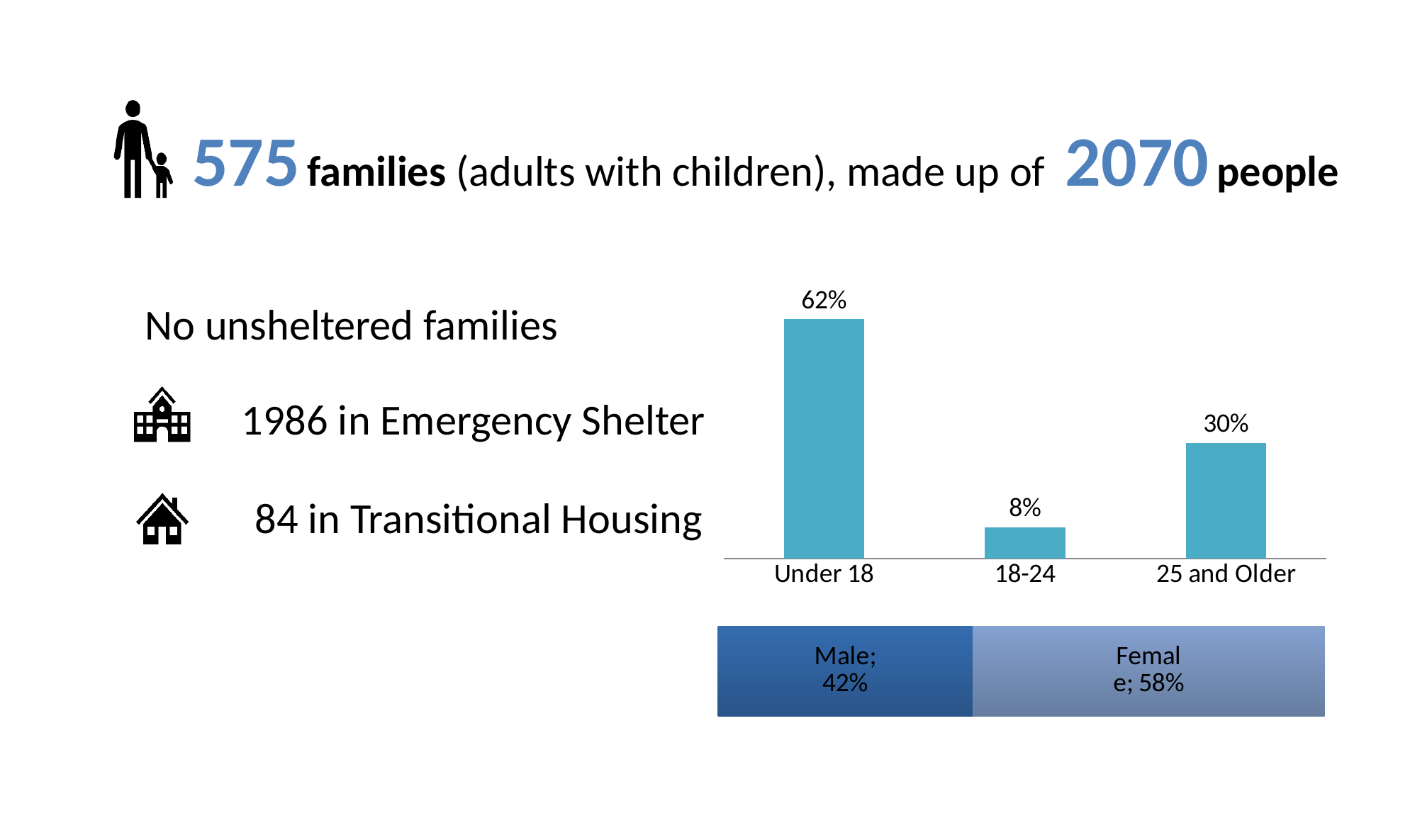
In the gender chart at the bottom, what is the total of the Male and Female segments? 100% In the age bar chart, which age group has the highest value? Under 18 In the age bar chart, what is the value for 18-24? 8% In the gender chart at the bottom, what is the value for Female? 58% In the age bar chart, what is the difference between the Under 18 and 25 and Older values? 32% In the age bar chart, what is the value for Under 18? 62% In the gender chart at the bottom, what is the value for Male? 42% What kind of chart is the age chart on the right? bar chart In the age bar chart, which age group has the lowest value? 18-24 In the age bar chart, what is the value for 25 and Older? 30% How many age categories are shown in the age bar chart? 3 In the age bar chart, which is larger: the value for 25 and Older or the value for 18-24? 25 and Older